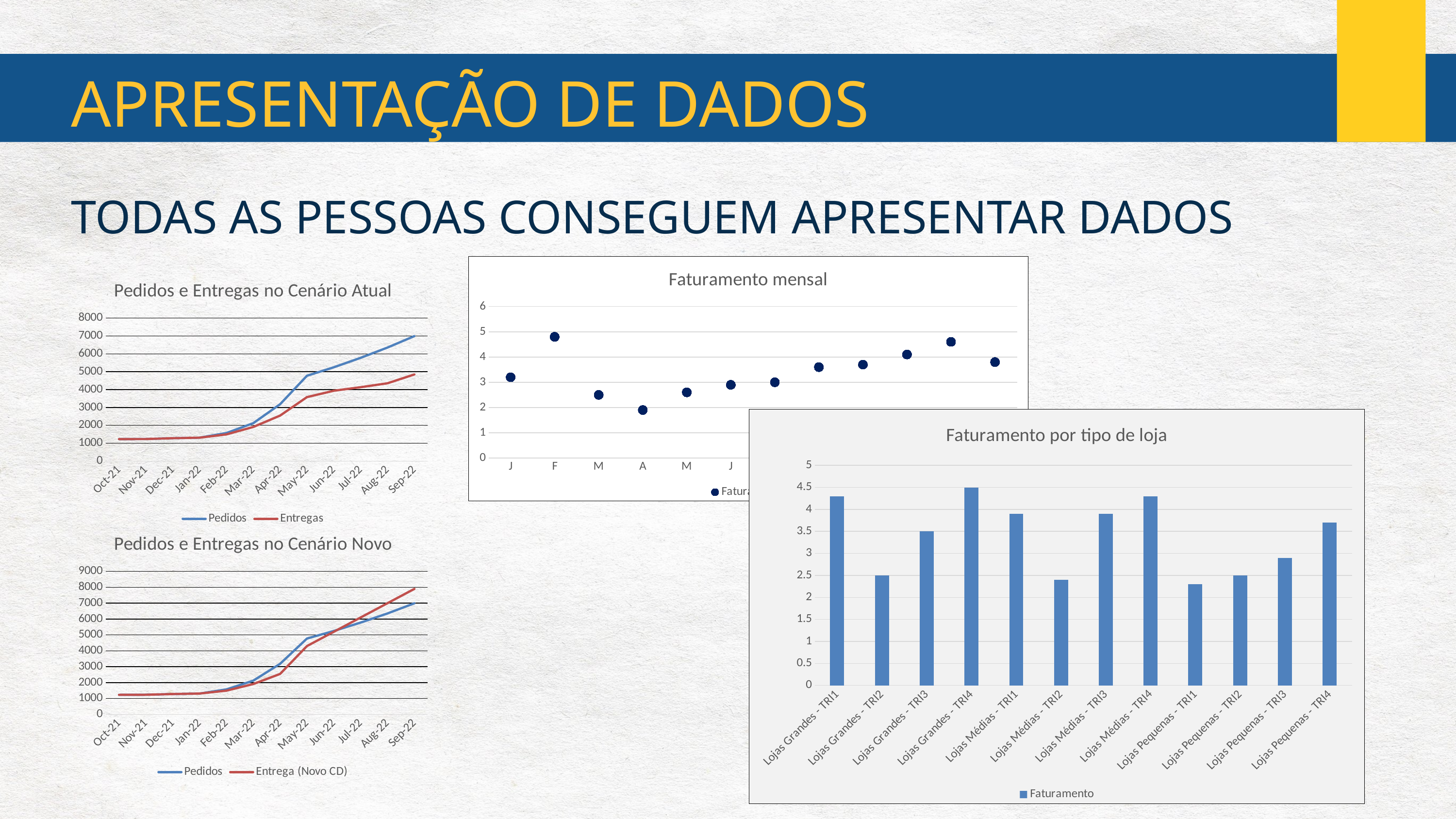
What kind of chart is "Faturamento por tipo de loja"? bar chart How many series does the legend of "Pedidos e Entregas no Cenário Novo" list? 2 In "Faturamento por tipo de loja", is the value for Lojas Médias - TRI1 greater or less than 3.5? greater In "Pedidos e Entregas no Cenário Atual", do the Pedidos values rise or fall from Oct-21 to Sep-22? rise In "Pedidos e Entregas no Cenário Novo", which series is higher at Sep-22: Pedidos or Entrega (Novo CD)? Entrega (Novo CD) In "Faturamento mensal", is the value for F greater or less than 4? greater In "Faturamento mensal", which month has the lowest value? A In "Faturamento por tipo de loja", which category has the highest value? Lojas Grandes - TRI4 In "Faturamento por tipo de loja", is the value for Lojas Pequenas - TRI1 greater or less than 2.5? less In "Faturamento por tipo de loja", which is larger: Lojas Pequenas - TRI4 or Lojas Pequenas - TRI3? Lojas Pequenas - TRI4 In "Faturamento por tipo de loja", how many categories are shown on the x axis? 12 What kind of chart is "Pedidos e Entregas no Cenário Atual"? line chart